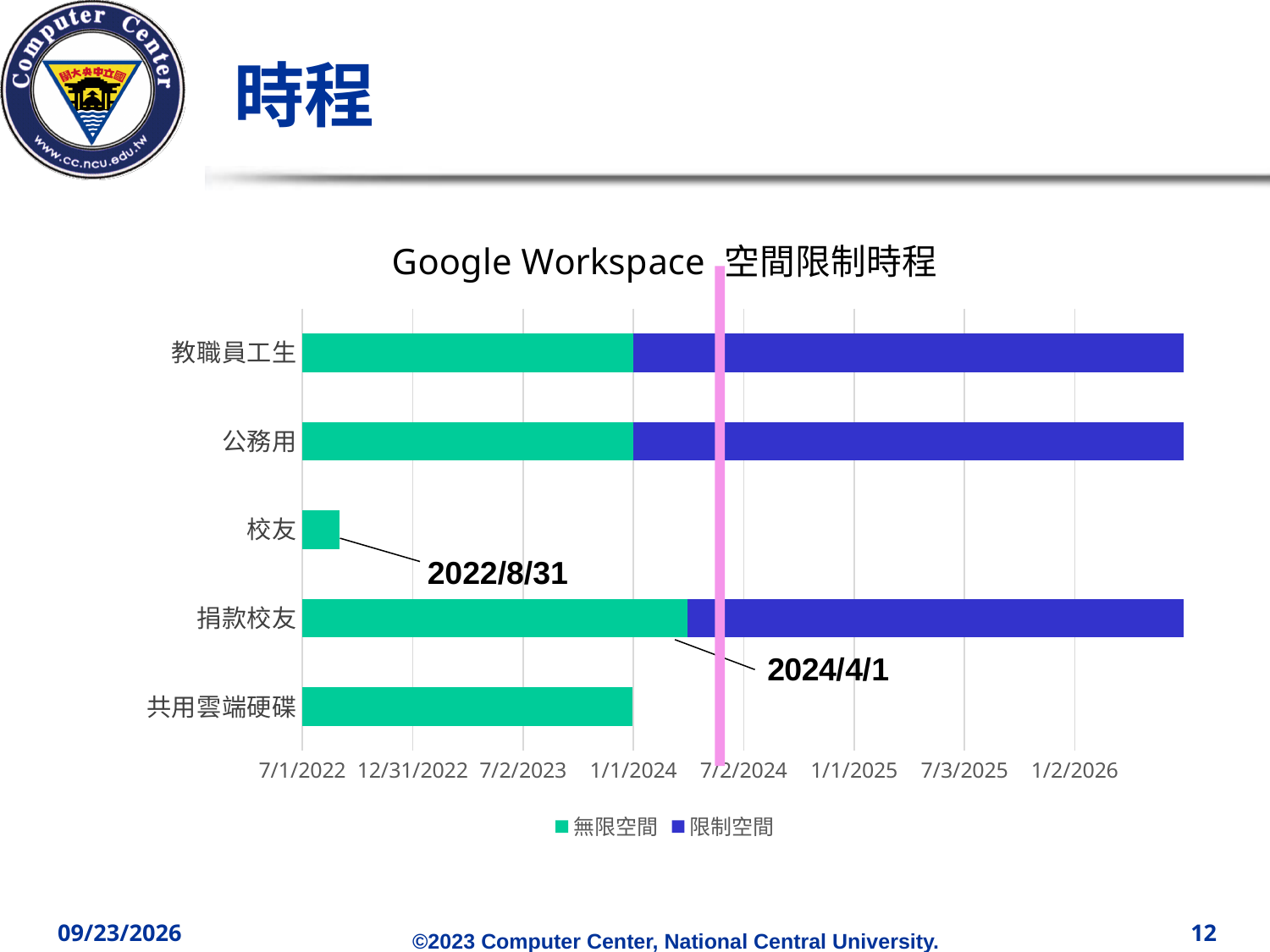
Which legend entry is shown in green? 無限空間 At which axis date does the 無限空間 segment for 教職員工生 end? 1/1/2024 Which category has the shortest bar overall? 校友 How many series does the legend list? 2 At which axis date does the 無限空間 bar for 共用雲端硬碟 end? 1/1/2024 Which category's 無限空間 segment extends furthest to the right? 捐款校友 On what date does 捐款校友 switch from 無限空間 to 限制空間, according to the annotation? 2024/4/1 What kind of chart is shown on the slide? bar chart How many categories are plotted on the chart? 5 Does the bar for 校友 end before or after 12/31/2022? before On what date does the 無限空間 bar for 校友 end, according to the annotation? 2022/8/31 What is the title of the chart? Google Workspace 空間限制時程